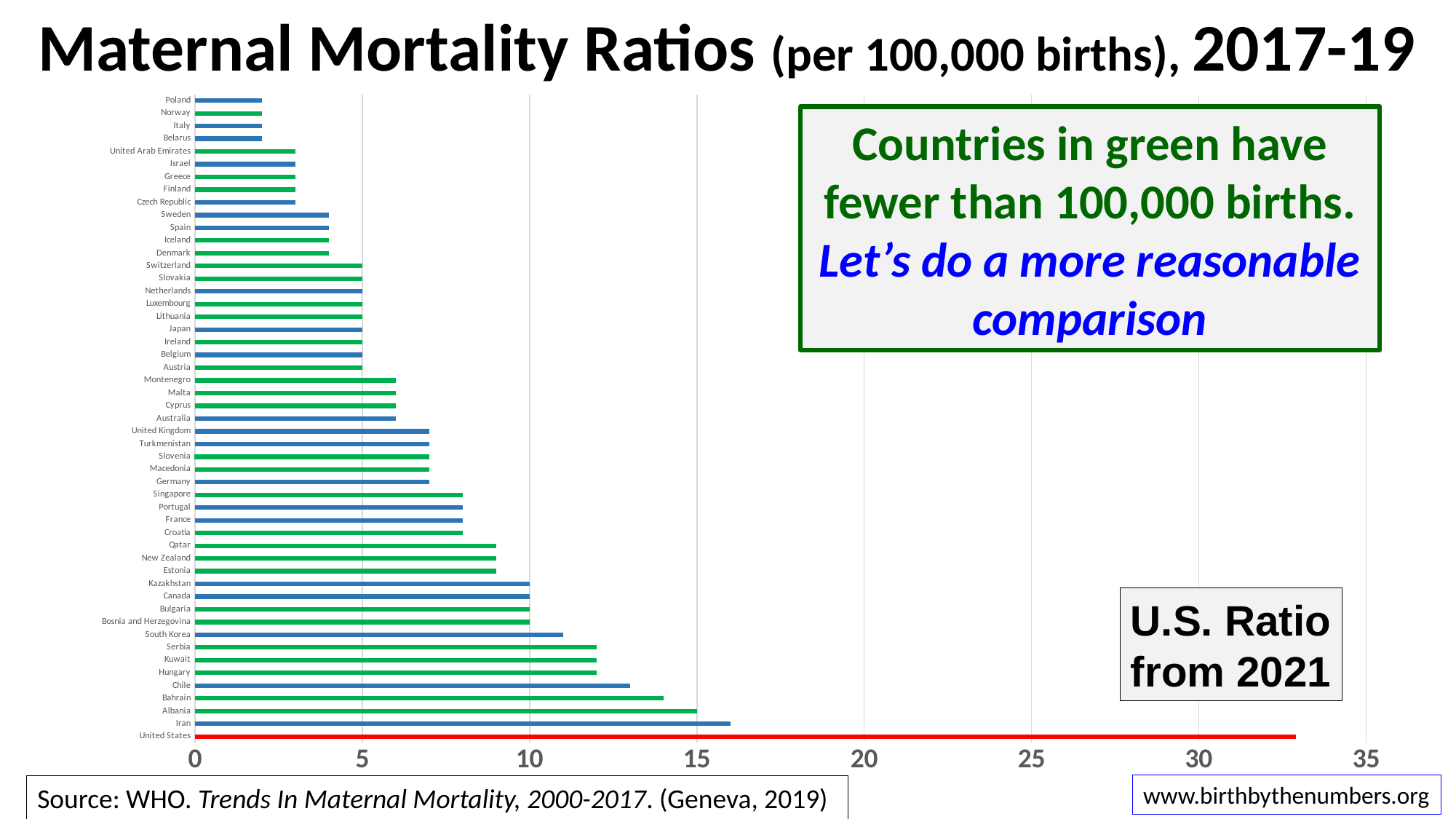
What is the maternal mortality ratio for Kazakhstan? 10 According to the text box, what do the countries shown in green have in common? Fewer than 100,000 births What is the maternal mortality ratio for Albania? 15 How many countries are listed on the chart? 51 Which has a higher maternal mortality ratio, Iran or Chile? Iran Is the value for Poland greater or less than 5? less What is the maternal mortality ratio for Switzerland? 5 Is the value for Chile greater or less than 10? greater Which country has the highest maternal mortality ratio on the chart? United States Is the value for the United States greater or less than 30? greater What kind of chart is shown on the slide? bar chart